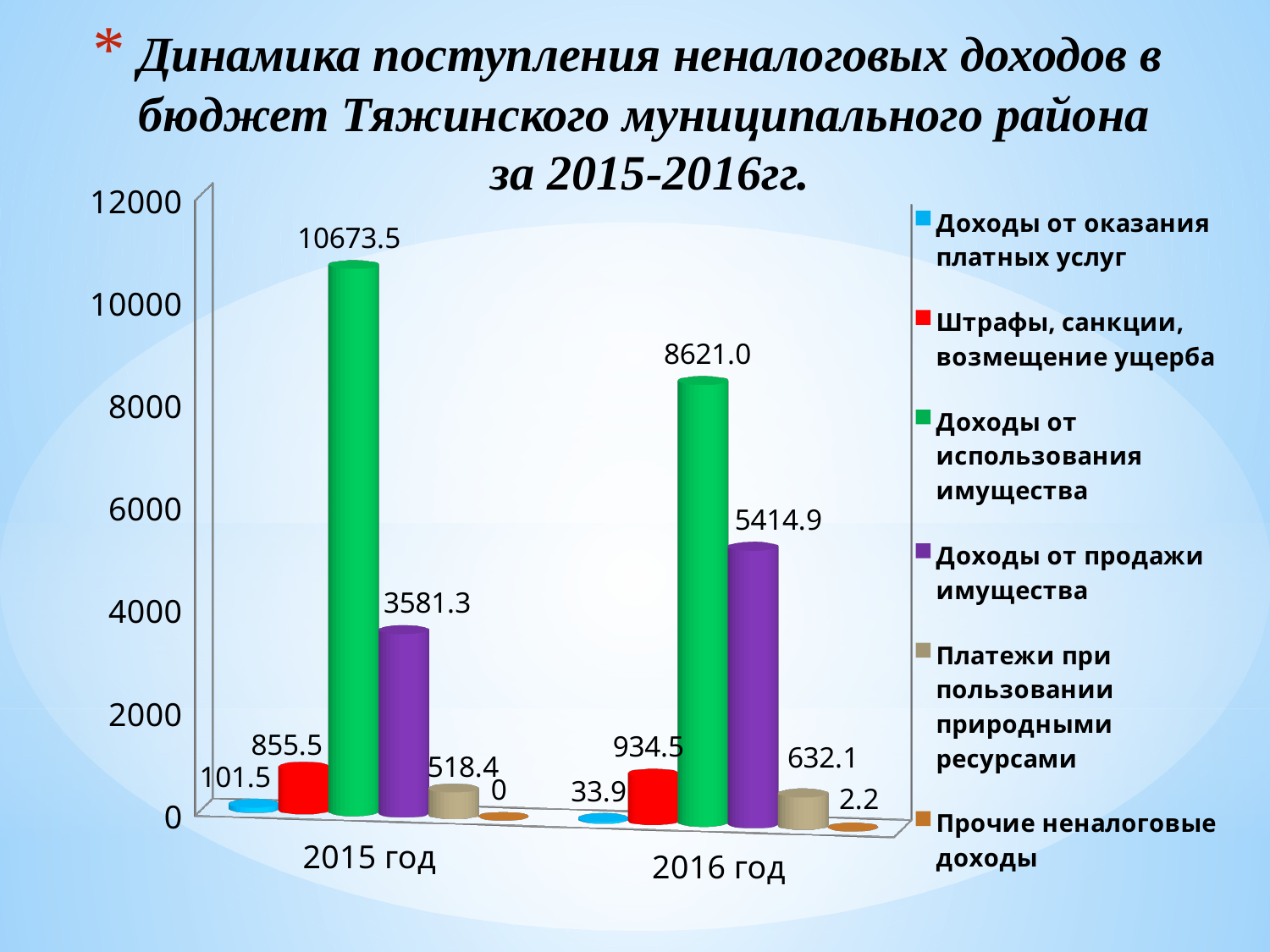
What is the value for Штрафы, санкции, возмещение ущерба in 2016 год? 934.5 What is the difference between the Доходы от использования имущества values for 2015 год and 2016 год? 2052.5 What is the value for Доходы от использования имущества in 2015 год? 10673.5 Which series has the highest value in 2016 год? Доходы от использования имущества How many series does the legend list? 6 What kind of chart is shown on the slide? Bar chart Does the value for Доходы от продажи имущества rise or fall from 2015 год to 2016 год? Rise What is the value for Доходы от оказания платных услуг in 2015 год? 101.5 What is the value for Прочие неналоговые доходы in 2016 год? 2.2 Which series has the lowest value in 2015 год? Прочие неналоговые доходы Which is larger: Платежи при пользовании природными ресурсами in 2015 год or in 2016 год? 2016 год What is the value for Доходы от продажи имущества in 2016 год? 5414.9